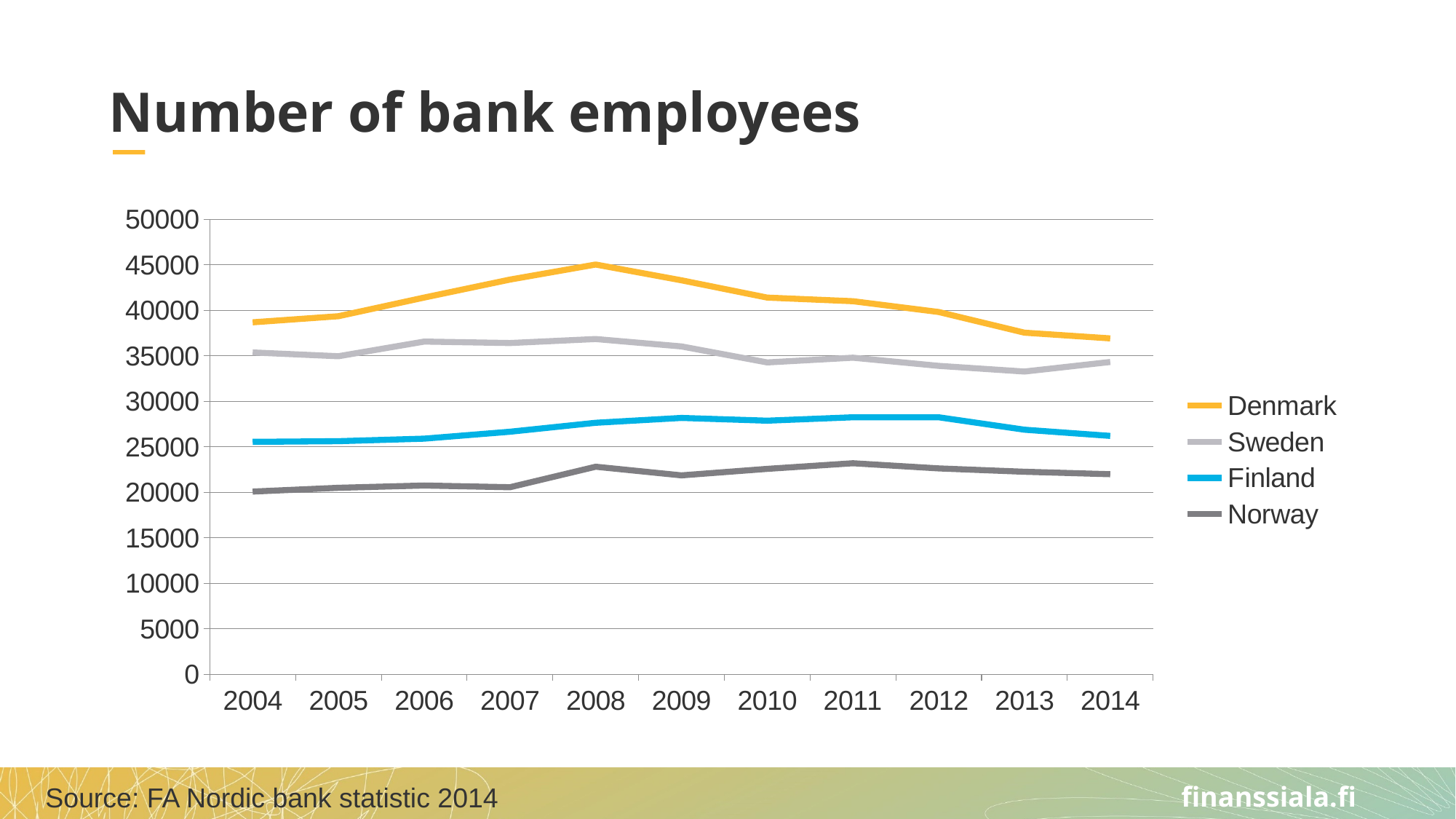
How many years are shown on the x axis? 11 Which is larger in 2010, the value for Denmark or the value for Sweden? Denmark What kind of chart is shown on the slide? line chart Is the value for Finland in 2011 greater or less than 25000? greater Is the value for Denmark in 2008 greater or less than 40000? greater Is the value for Sweden in 2013 greater or less than 35000? less How many series does the legend list? 4 Does the number of bank employees in Denmark rise or fall from 2008 to 2014? fall Which country has the lowest number of bank employees in 2014? Norway Which country has the highest number of bank employees in 2008? Denmark In which year does Denmark's number of bank employees peak? 2008